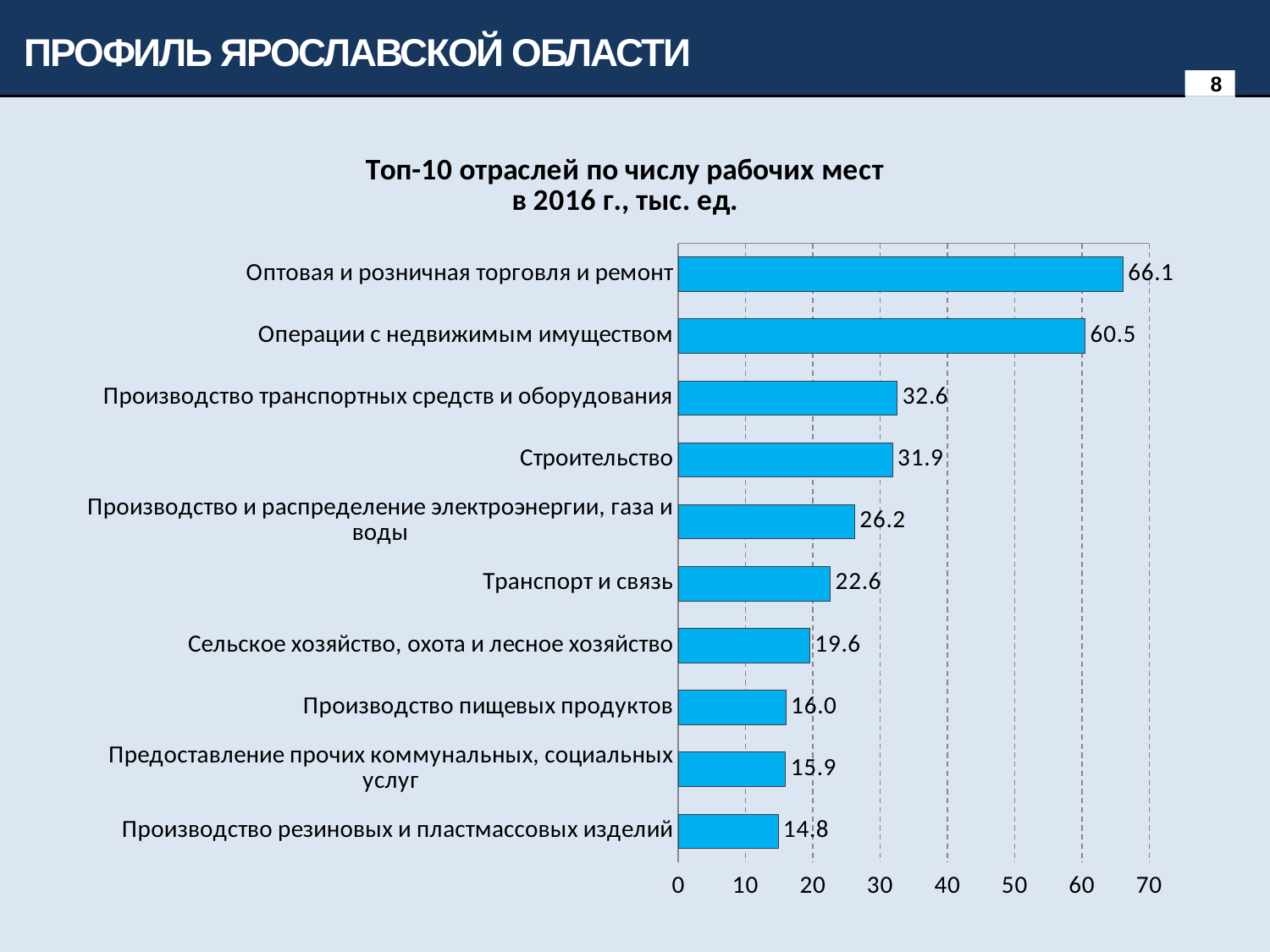
What is the value for Строительство? 31.9 What kind of chart is shown on the slide? bar chart What is the title of the chart? Топ-10 отраслей по числу рабочих мест в 2016 г., тыс. ед. What is the value for Производство пищевых продуктов? 16.0 What is the difference between the values for Оптовая и розничная торговля и ремонт and Операции с недвижимым имуществом? 5.6 Is the value for Операции с недвижимым имуществом greater or less than 50? greater Which is larger: the value for Производство и распределение электроэнергии, газа и воды or the value for Транспорт и связь? Производство и распределение электроэнергии, газа и воды How many categories are shown in the chart? 10 What is the difference between the values for Производство транспортных средств и оборудования and Сельское хозяйство, охота и лесное хозяйство? 13.0 What is the value for Транспорт и связь? 22.6 Which category has the highest value? Оптовая и розничная торговля и ремонт Which category has the lowest value? Производство резиновых и пластмассовых изделий